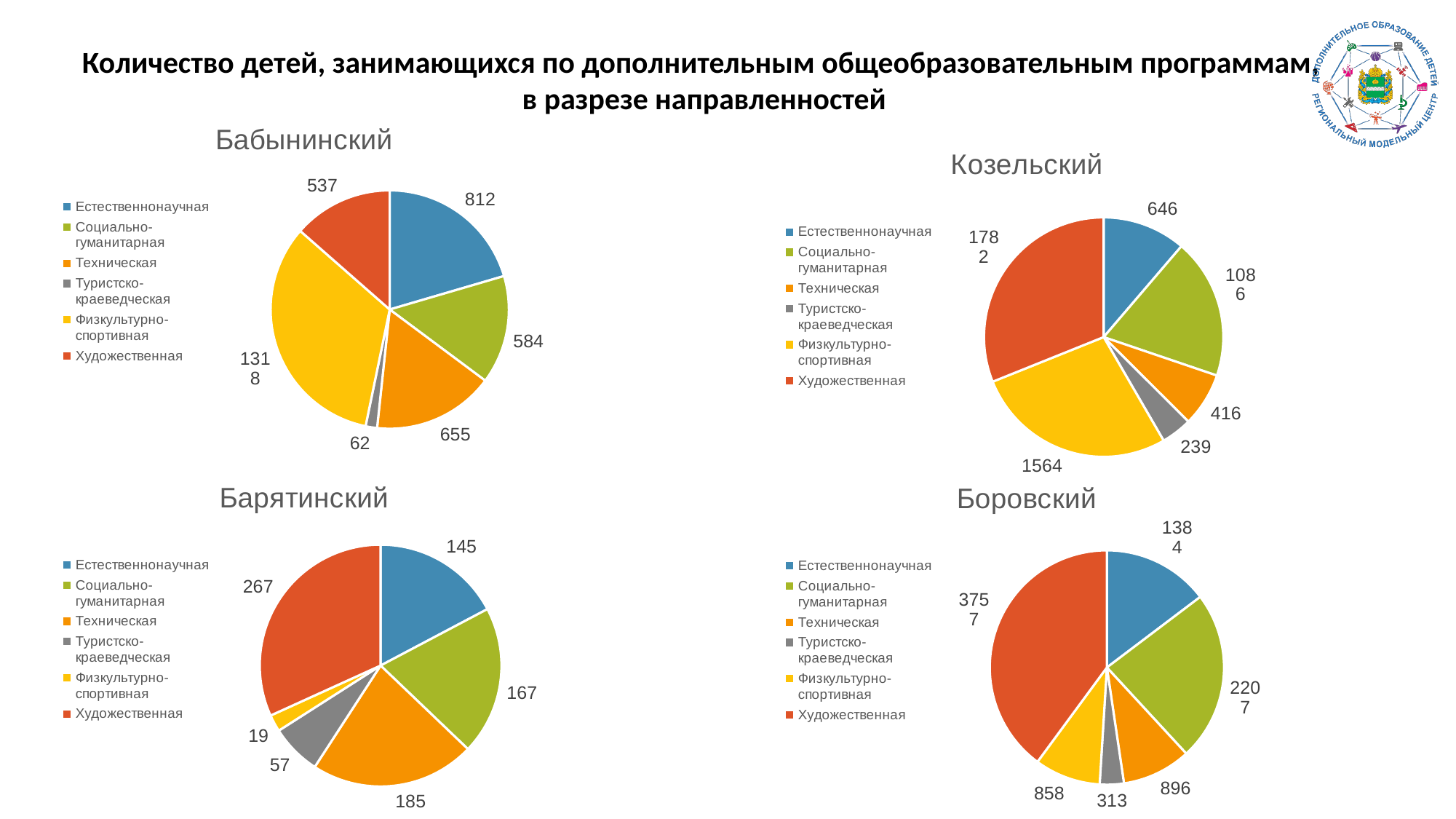
How many categories does the legend of the Боровский chart list? 6 In the Козельский chart, which category has the largest value? Художественная In the Козельский chart, what is the value for Физкультурно-спортивная? 1564 What kind of chart is used for Бабынинский? pie chart In the Бабынинский chart, which category has the smallest value? Туристско-краеведческая In the Боровский chart, what is the value for Техническая? 896 In the Бабынинский chart, what is the value for Естественнонаучная? 812 In the Барятинский chart, what is the value for Художественная? 267 In the Козельский chart, what is the difference between Техническая and Туристско-краеведческая? 177 In the Боровский chart, what is the difference between Техническая and Физкультурно-спортивная? 38 In the Барятинский chart, which is larger, Техническая or Социально-гуманитарная? Техническая In the Барятинский chart, which category has the smallest value? Физкультурно-спортивная